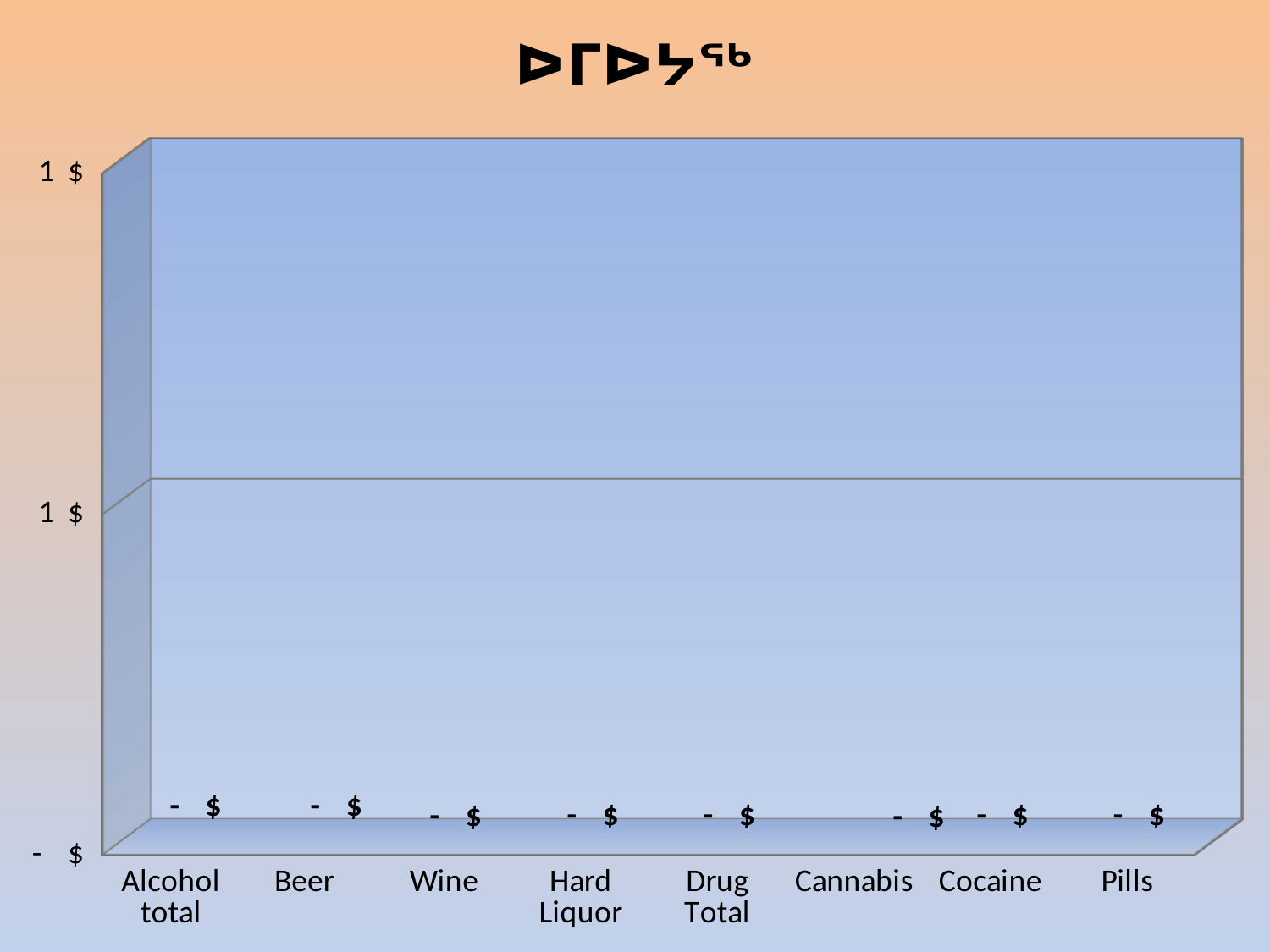
How many categories are shown on the x axis of the chart? 8 What value is labelled for Drug Total? - $ Do the values rise, fall, or stay the same across the categories from left to right? stay the same What value is labelled for Alcohol total? - $ Which category is listed last on the x axis? Pills Is the value for Beer greater or less than 1 $? less What value is labelled for Cannabis? - $ What is the difference between the values for Wine and Hard Liquor? - $ Is the value for Cocaine greater or less than 1 $? less Which category is listed first on the x axis? Alcohol total What kind of chart is shown on the slide? bar chart What value is labelled for Pills? - $